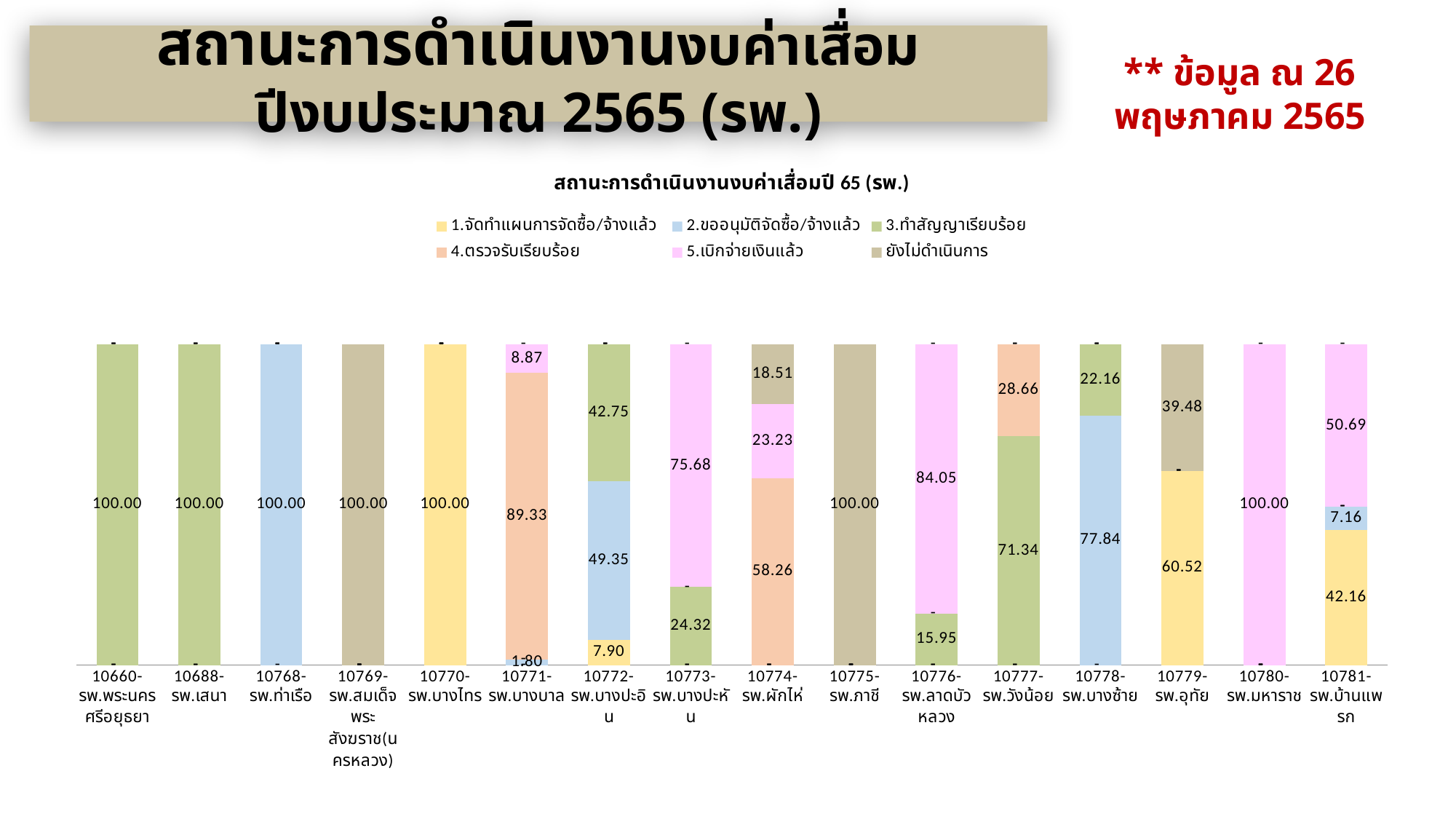
What is the value of 1.จัดทำแผนการจัดซื้อ/จ้างแล้ว for 10779-รพ.อุทัย? 60.52 What is the value of 2.ขออนุมัติจัดซื้อ/จ้างแล้ว for 10781-รพ.บ้านแพรก? 7.16 What kind of chart is shown on the slide? stacked bar chart How many series does the legend list? 6 How many hospitals (categories) are shown on the x axis? 16 What is the value of 5.เบิกจ่ายเงินแล้ว for 10773-รพ.บางปะหัน? 75.68 Which is larger for 10772-รพ.บางปะอิน: the 2.ขออนุมัติจัดซื้อ/จ้างแล้ว value or the 3.ทำสัญญาเรียบร้อย value? 2.ขออนุมัติจัดซื้อ/จ้างแล้ว What is the total of the stacked bar for 10776-รพ.ลาดบัวหลวง? 100.00 What is the difference between the 3.ทำสัญญาเรียบร้อย value and the 4.ตรวจรับเรียบร้อย value for 10777-รพ.วังน้อย? 42.68 What is the value of 4.ตรวจรับเรียบร้อย for 10771-รพ.บางบาล? 89.33 What is the title of the chart? สถานะการดำเนินงานงบค่าเสื่อมปี 65 (รพ.) What is the value of ยังไม่ดำเนินการ for 10774-รพ.ผักไห่? 18.51